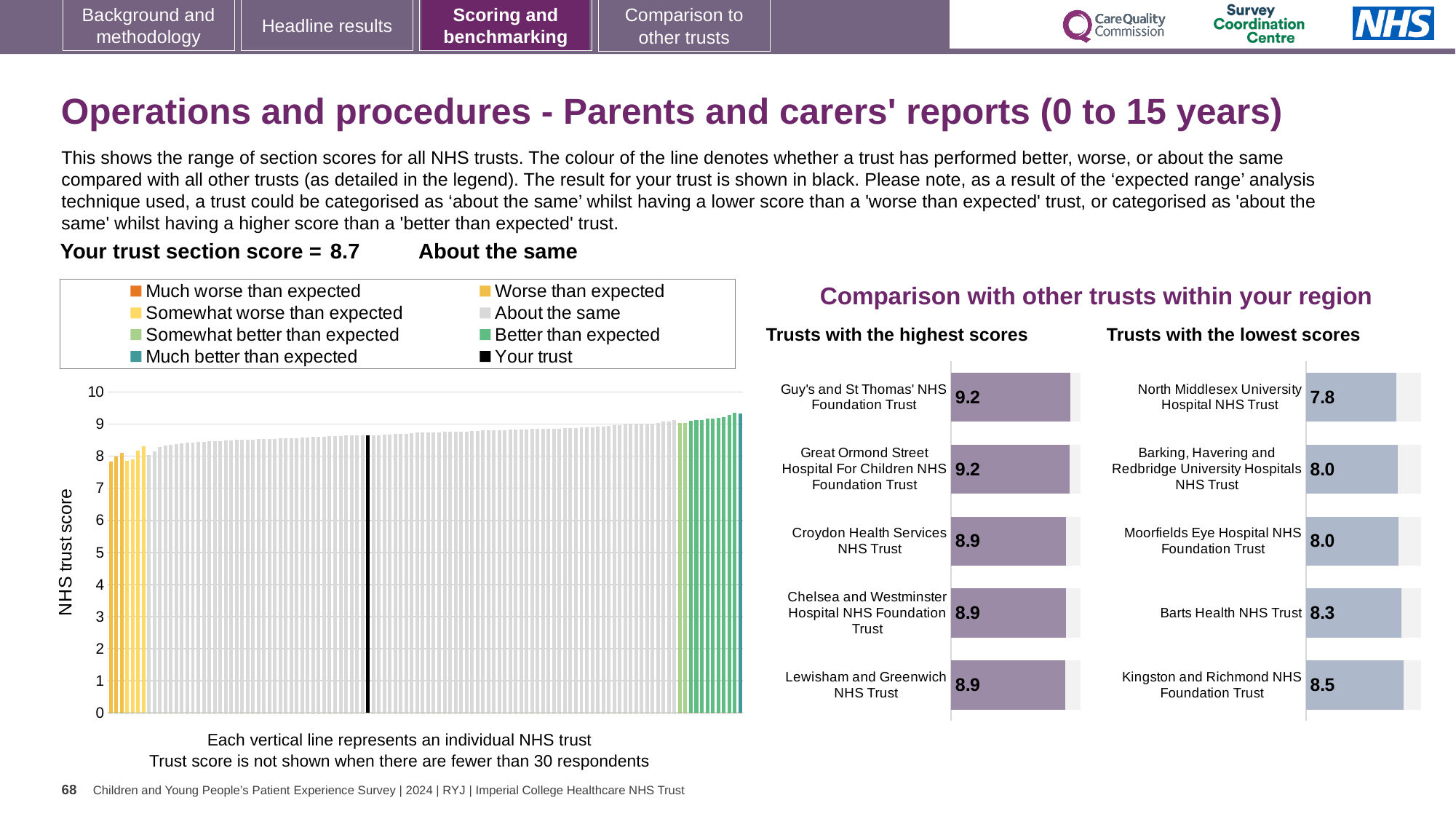
In the 'Trusts with the highest scores' chart, what is the difference between the scores of Guy's and St Thomas' NHS Foundation Trust and Lewisham and Greenwich NHS Trust? 0.3 How many entries does the legend of the NHS trust score chart on the left list? 8 In the 'Trusts with the lowest scores' chart, which trust has the lowest score? North Middlesex University Hospital NHS Trust In the 'Trusts with the highest scores' chart, what is the score for Guy's and St Thomas' NHS Foundation Trust? 9.2 How many trusts are listed in the 'Trusts with the highest scores' chart? 5 In the 'Trusts with the lowest scores' chart, which trust has the highest score? Kingston and Richmond NHS Foundation Trust In the 'Trusts with the lowest scores' chart, what is the score for North Middlesex University Hospital NHS Trust? 7.8 In the 'Trusts with the lowest scores' chart, what is the score for Barts Health NHS Trust? 8.3 In the 'Trusts with the lowest scores' chart, which has the larger score: Barts Health NHS Trust or Moorfields Eye Hospital NHS Foundation Trust? Barts Health NHS Trust In the NHS trust score chart on the left, is the value for the black 'Your trust' bar greater or less than 8? greater In the 'Trusts with the lowest scores' chart, what is the difference between the scores of Kingston and Richmond NHS Foundation Trust and North Middlesex University Hospital NHS Trust? 0.7 In the 'Trusts with the highest scores' chart, what is the score for Croydon Health Services NHS Trust? 8.9